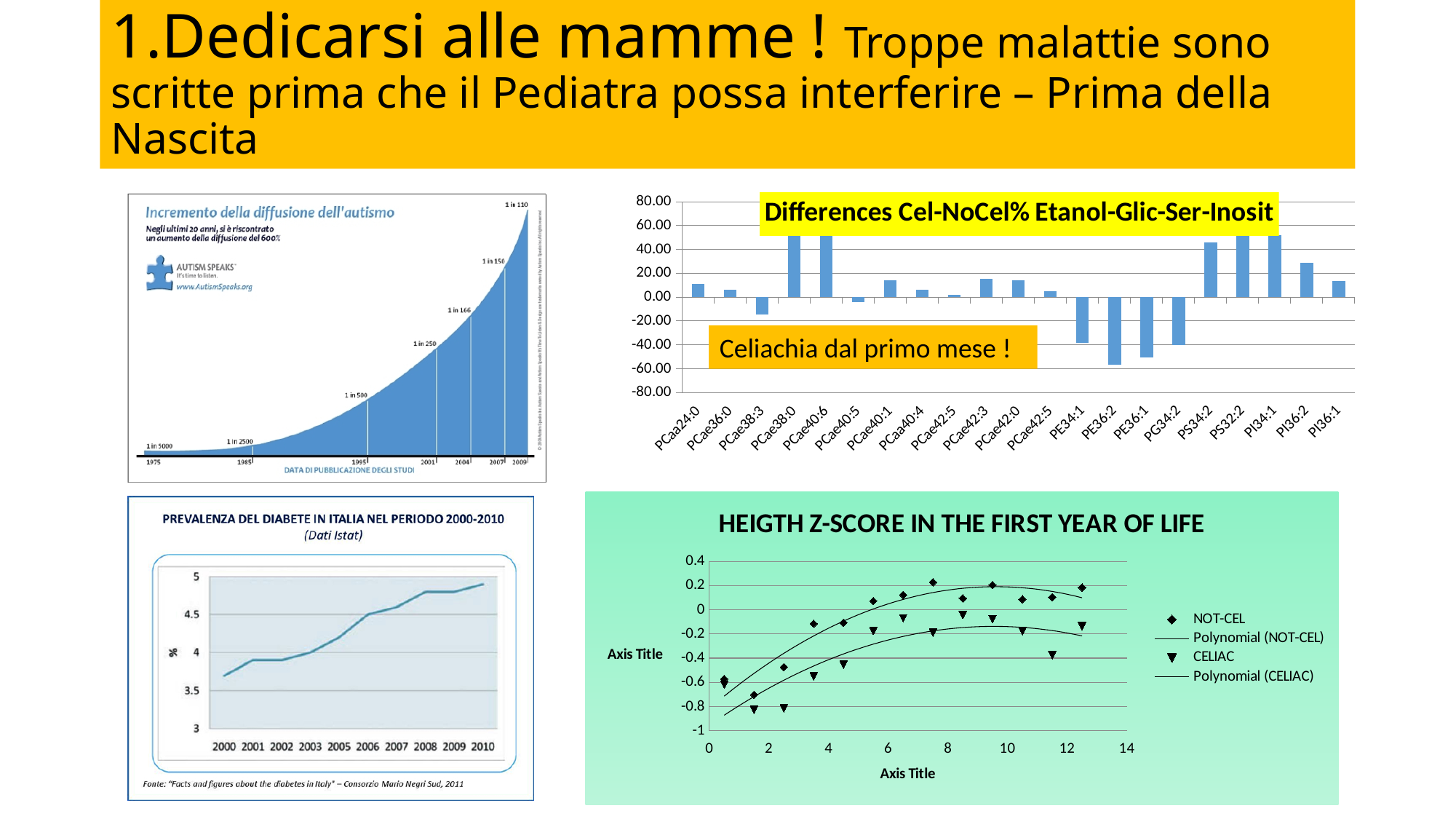
In the 'HEIGTH Z-SCORE IN THE FIRST YEAR OF LIFE' chart, which series is plotted with triangle markers? CELIAC In the 'Incremento della diffusione dell'autismo' chart, what is the autism prevalence labelled for 1975? 1 in 5000 How many categories are shown on the x axis of the 'Differences Cel-NoCel% Etanol-Glic-Ser-Inosit' chart? 21 In the 'Differences Cel-NoCel% Etanol-Glic-Ser-Inosit' chart, is the value for PE36:2 greater or less than -40.00? less What kind of chart is the 'Differences Cel-NoCel% Etanol-Glic-Ser-Inosit' chart? bar chart In the 'Differences Cel-NoCel% Etanol-Glic-Ser-Inosit' chart, which is larger, the value for PCae38:0 or the value for PCae38:3? PCae38:0 How many entries does the legend of the 'HEIGTH Z-SCORE IN THE FIRST YEAR OF LIFE' chart list? 4 In the 'Differences Cel-NoCel% Etanol-Glic-Ser-Inosit' chart, is the value for PI36:2 greater or less than 20.00? greater In the 'PREVALENZA DEL DIABETE IN ITALIA NEL PERIODO 2000-2010' chart, do the values rise or fall from 2000 to 2010? rise What kind of chart is the 'HEIGTH Z-SCORE IN THE FIRST YEAR OF LIFE' chart? scatter chart In the 'Incremento della diffusione dell'autismo' chart, what is the autism prevalence labelled for 2009? 1 in 110 In the 'Differences Cel-NoCel% Etanol-Glic-Ser-Inosit' chart, which category has the lowest value? PE36:2